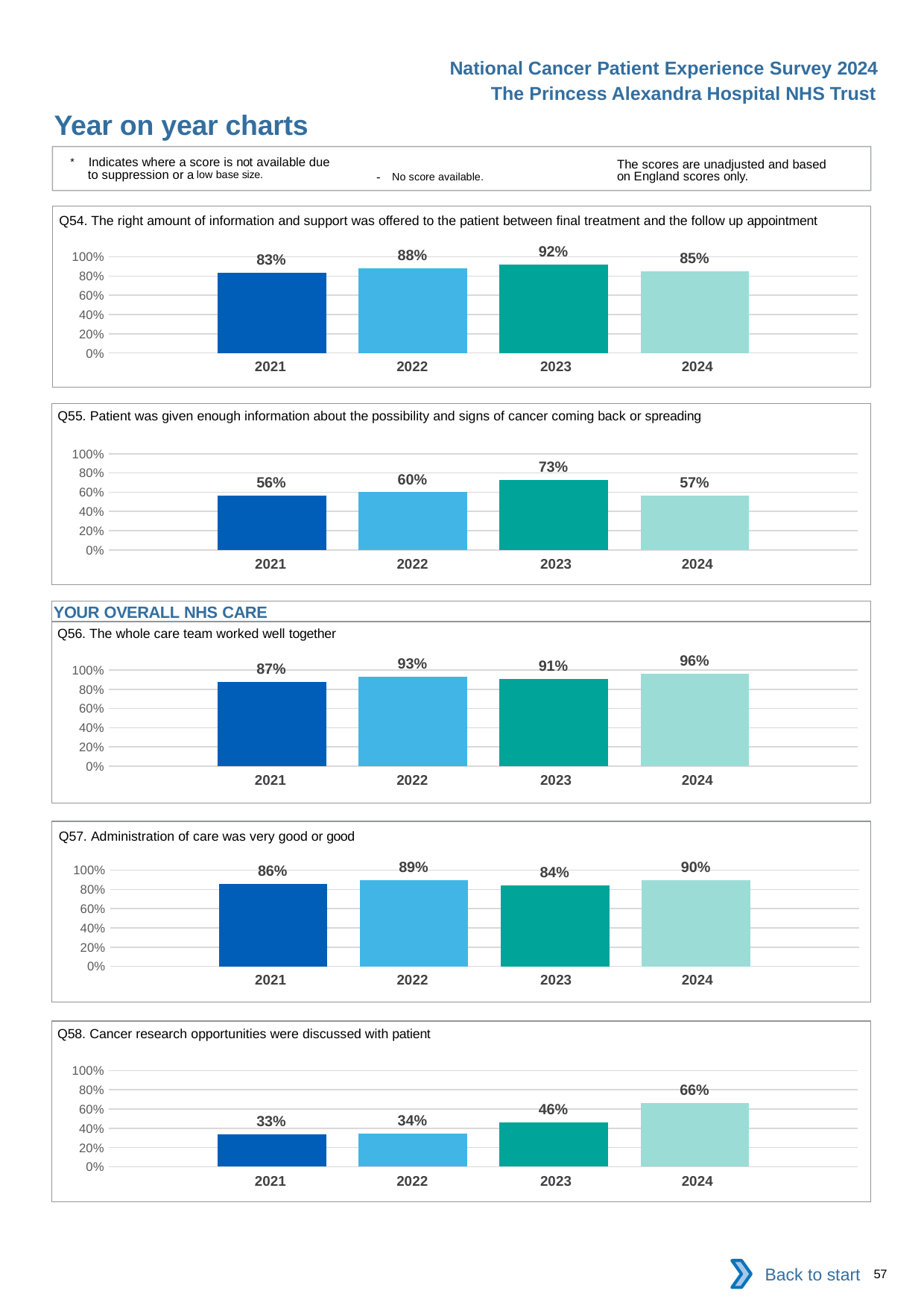
In the Q55 chart, which year has the highest value? 2023 In the Q56 chart, what is the value for 2024? 96% What is the section heading printed above the Q56 chart? YOUR OVERALL NHS CARE In the Q54 chart, what is the value for 2023? 92% In the Q58 chart, what is the value for 2021? 33% In the Q57 chart, which is larger, the value for 2022 or the value for 2023? 2022 In the Q57 chart, what is the difference between the 2024 and 2021 values? 4% In the Q56 chart, which year has the lowest value? 2021 What kind of chart is the Q58 chart? bar chart How many years are shown on the x axis of the Q54 chart? 4 In the Q55 chart, what is the difference between the 2023 and 2024 values? 16% In the Q58 chart, do the values rise or fall from 2021 to 2024? rise